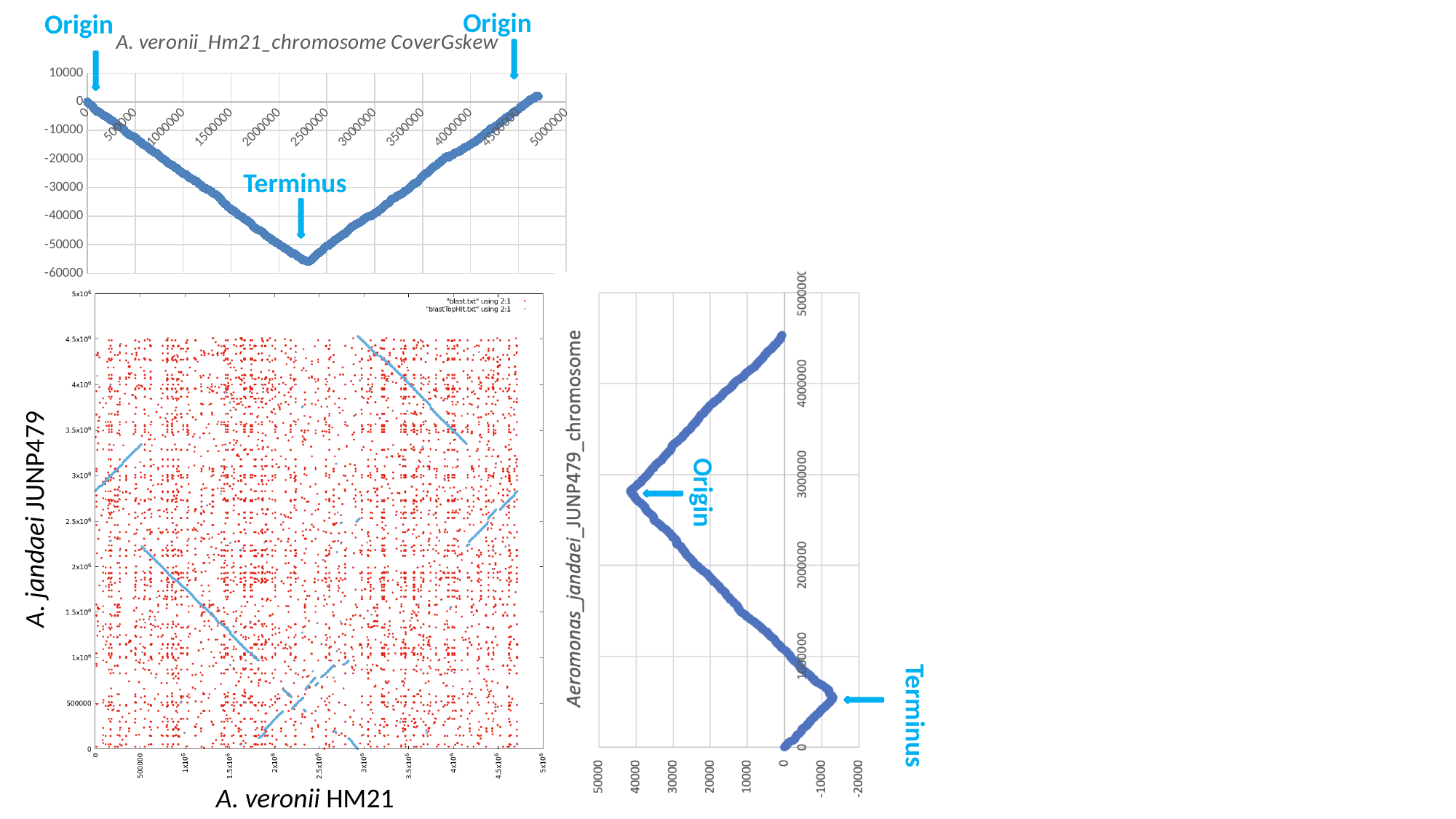
What is the title of the chart at the top left of the slide? A. veronii_Hm21_chromosome CoverGskew What kind of chart is the bottom-left chart with axes 'A. veronii HM21' and 'A. jandaei JUNP479'? scatter chart In the chart on the right titled 'Aeromonas_jandaei_JUNP479_chromosome', is the lowest value greater or less than 0? less In the top-left chart titled 'A. veronii_Hm21_chromosome CoverGskew', do the values rise or fall along the x axis between 2500000 and 5000000? rise In the top-left chart titled 'A. veronii_Hm21_chromosome CoverGskew', which annotation label marks the lowest point of the curve? Terminus In the top-left chart titled 'A. veronii_Hm21_chromosome CoverGskew', is the lowest value greater or less than -50000? less What is the x-axis label of the bottom-left scatter chart? A. veronii HM21 In the top-left chart titled 'A. veronii_Hm21_chromosome CoverGskew', do the values rise or fall along the x axis between 0 and 2500000? fall In the chart on the right titled 'Aeromonas_jandaei_JUNP479_chromosome', is the highest value greater or less than 30000? greater How many series does the legend of the bottom-left scatter chart list? 2 How many charts are shown on the slide? 3